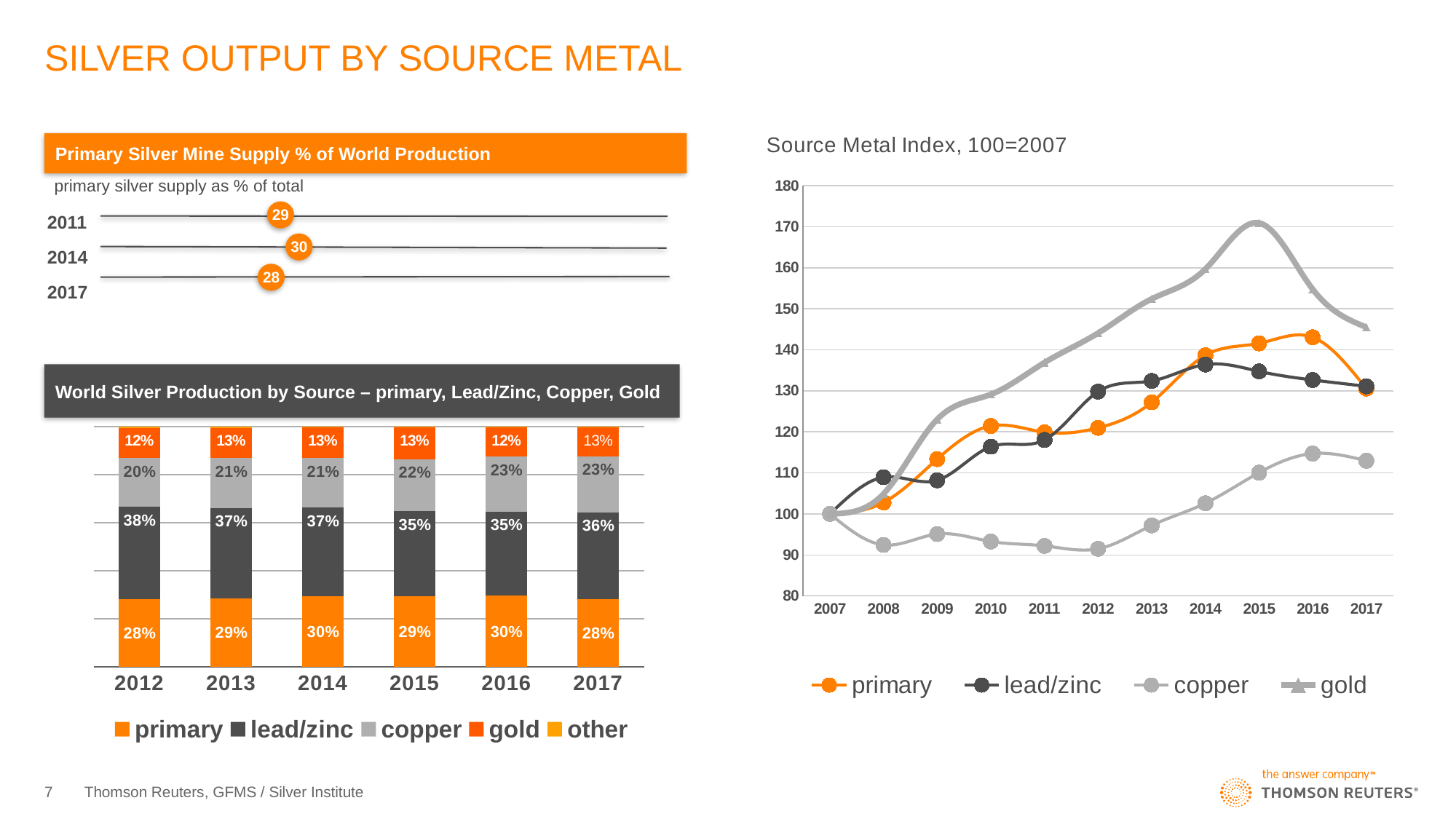
In the 'Source Metal Index, 100=2007' chart, is the value for gold in 2015 greater or less than 160? greater In the 'World Silver Production by Source' chart, which is larger in 2015: the primary share or the copper share? primary In the 'Primary Silver Mine Supply % of World Production' chart, what is the value for 2014? 30 In the 'Primary Silver Mine Supply % of World Production' chart, which year has the lowest value? 2017 In the 'World Silver Production by Source' chart, what is the lead/zinc share in 2012? 38% How many entries does the legend of the 'World Silver Production by Source' chart list? 5 How many years are shown on the x axis of the 'World Silver Production by Source' chart? 6 In the 'World Silver Production by Source' chart, what is the copper share in 2016? 23% In the 'World Silver Production by Source' chart, what is the difference between the lead/zinc share in 2012 and in 2017? 2 percentage points In the 'Source Metal Index, 100=2007' chart, which series reaches the highest value? gold In the 'Source Metal Index, 100=2007' chart, is the value for copper in 2012 greater or less than 100? less What kind of chart is 'Source Metal Index, 100=2007'? line chart